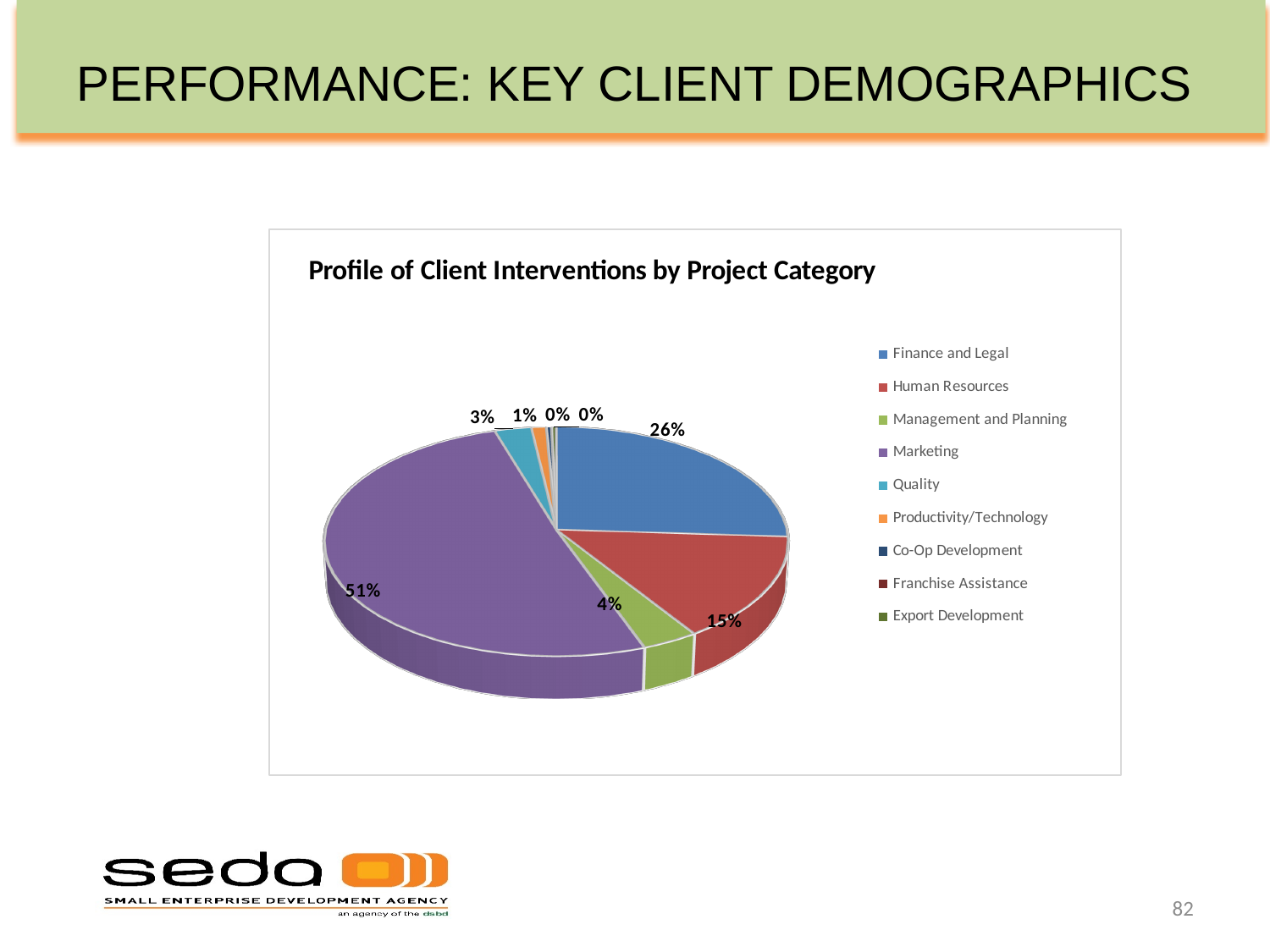
What kind of chart is shown on the slide? Pie chart What percentage is shown for Productivity/Technology? 1% What percentage is shown for Management and Planning? 4% What percentage is shown for Finance and Legal? 26% What is the title of the chart? Profile of Client Interventions by Project Category What percentage is shown for Human Resources? 15% What percentage is shown for Quality? 3% Which project category has the largest share of client interventions? Marketing How many project categories are listed in the chart legend? 9 What share of client interventions does Marketing account for? 51% How many percentage points larger is the Marketing share than the Finance and Legal share? 25 percentage points Which has the larger share, Human Resources or Management and Planning? Human Resources